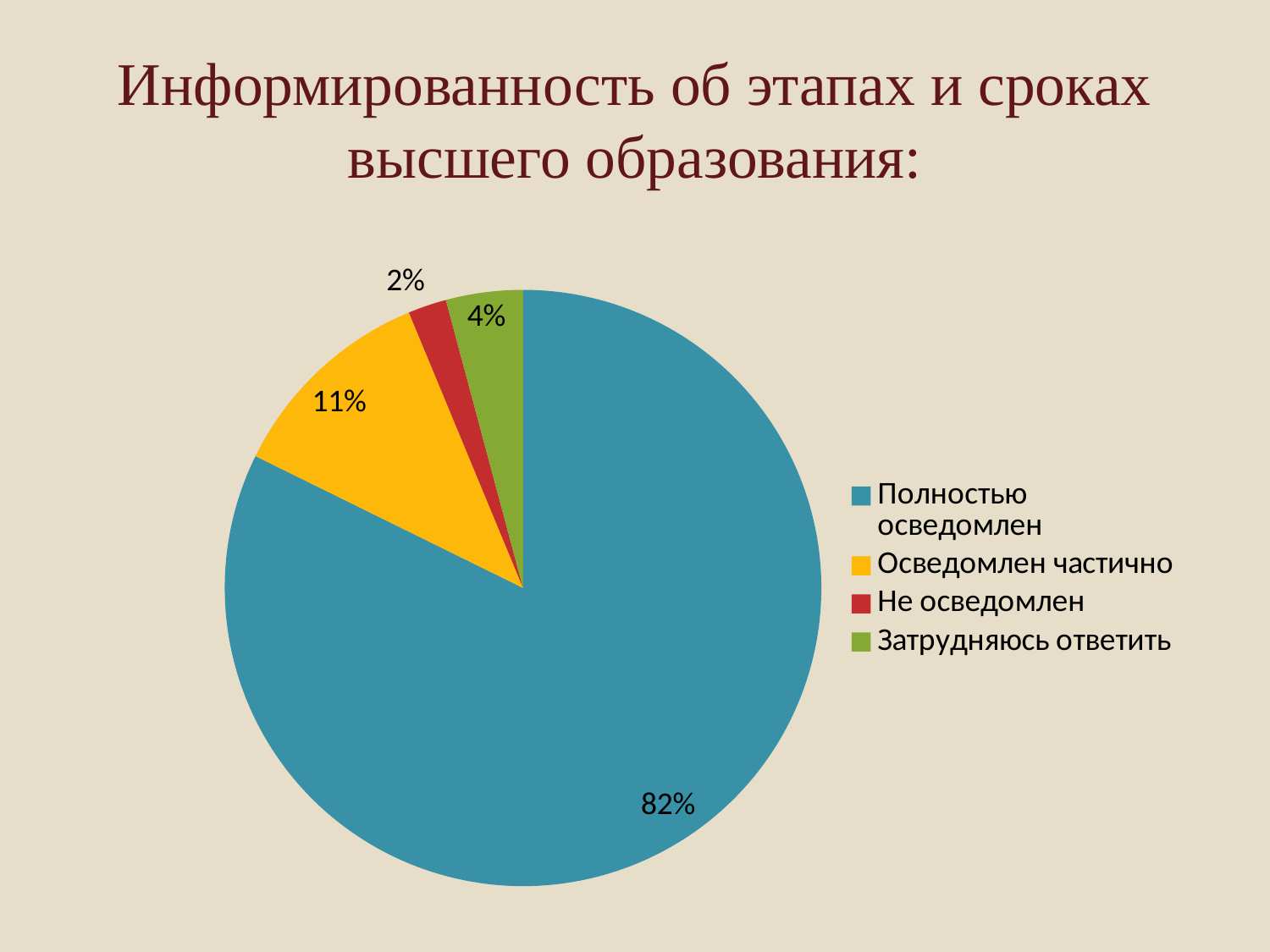
What percentage is shown for "Осведомлен частично"? 11% Which is larger, the slice for "Затрудняюсь ответить" or the slice for "Не осведомлен"? Затрудняюсь ответить What kind of chart is shown on the slide? Pie chart Which category has the smallest slice of the pie? Не осведомлен What share of the pie is labelled "Полностью осведомлен"? 82% What colour is the slice for "Осведомлен частично"? Yellow What percentage is shown for "Не осведомлен"? 2% What percentage is shown for "Затрудняюсь ответить"? 4% What is the difference in percentage points between "Полностью осведомлен" and "Осведомлен частично"? 71 Which category has the largest slice of the pie? Полностью осведомлен What is the title of the chart on the slide? Информированность об этапах и сроках высшего образования: How many categories does the pie chart have? 4